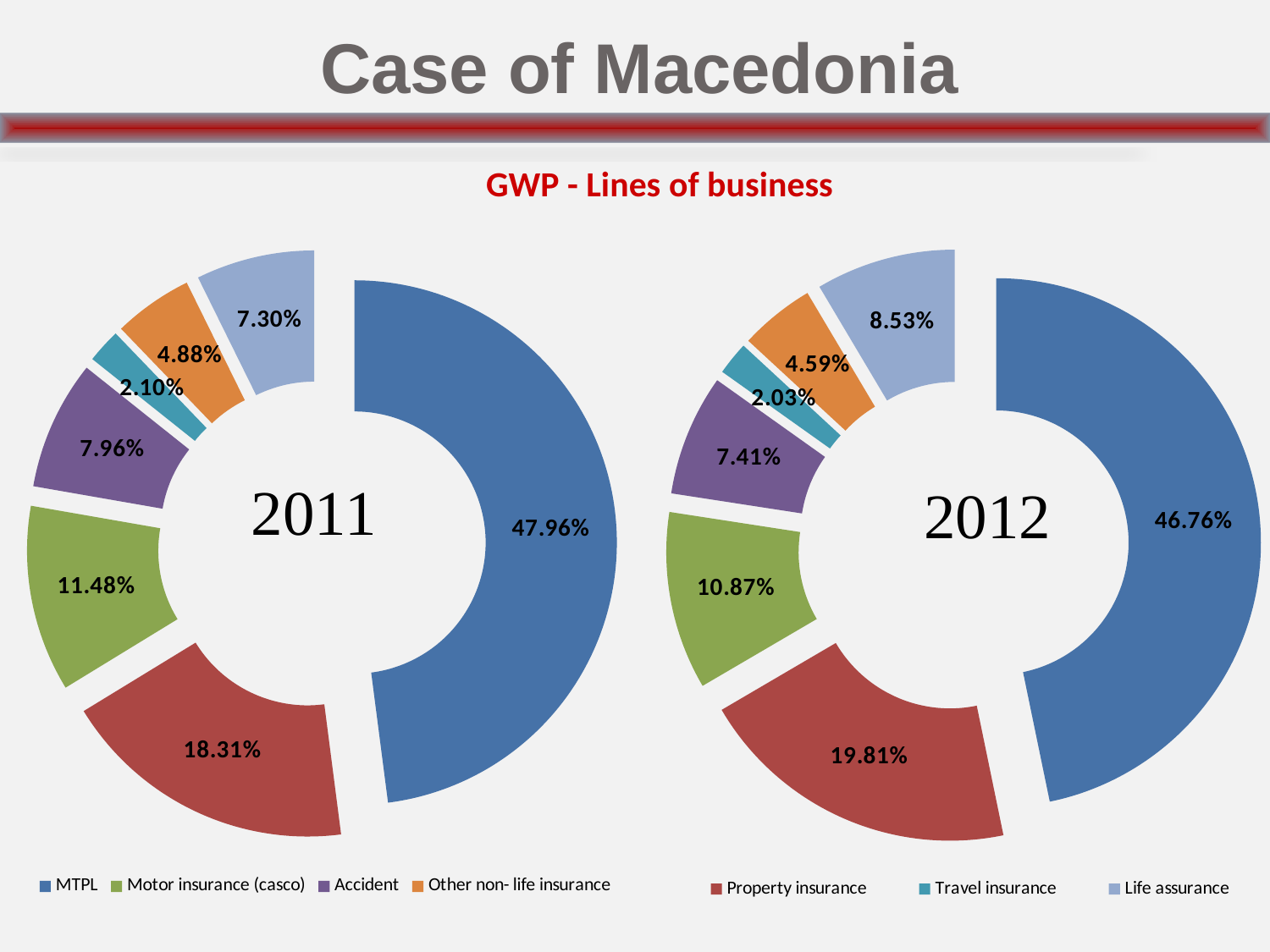
In the 2011 chart, what share does Motor insurance (casco) have? 11.48% What is the title shown above the two charts? GWP - Lines of business In the 2011 chart, what share does MTPL have? 47.96% In the 2012 chart, which is larger: the share of Accident or the share of Other non-life insurance? Accident In the 2011 chart, what share does Accident have? 7.96% What kind of chart is used to show the GWP lines of business? Doughnut (pie) chart In the 2012 chart, what share does Property insurance have? 19.81% In the 2011 chart, which line of business has the smallest share? Travel insurance In the 2012 chart, which line of business has the largest share? MTPL In the 2012 chart, what share does Life assurance have? 8.53% What is the difference between the MTPL share in 2011 and in 2012? 1.20% How many lines of business are shown in each chart? 7